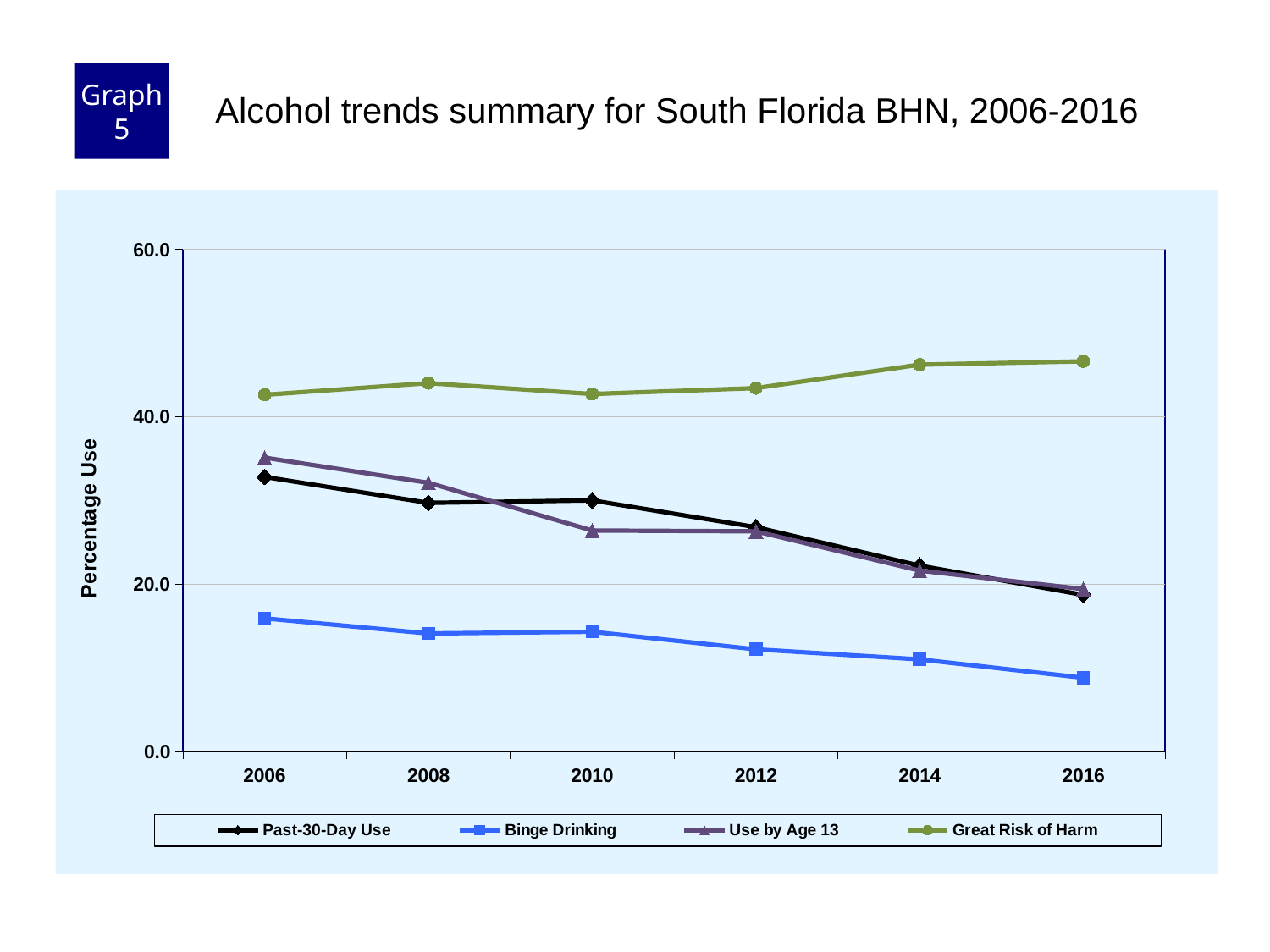
What kind of chart is shown on the slide? line chart Which series has the lowest values across all years? Binge Drinking What is the label on the y axis? Percentage Use Is the value for Great Risk of Harm in 2016 greater or less than 40.0? greater In 2006, which is larger: Use by Age 13 or Binge Drinking? Use by Age 13 Does the Binge Drinking line rise or fall from 2006 to 2016? fall How many series does the legend list? 4 Is the value for Past-30-Day Use in 2006 greater or less than 20.0? greater Is the value for Binge Drinking in 2016 greater or less than 20.0? less How many years are plotted along the x axis? 6 Which series has the highest values across all years? Great Risk of Harm Does the Great Risk of Harm line rise or fall overall from 2006 to 2016? rise